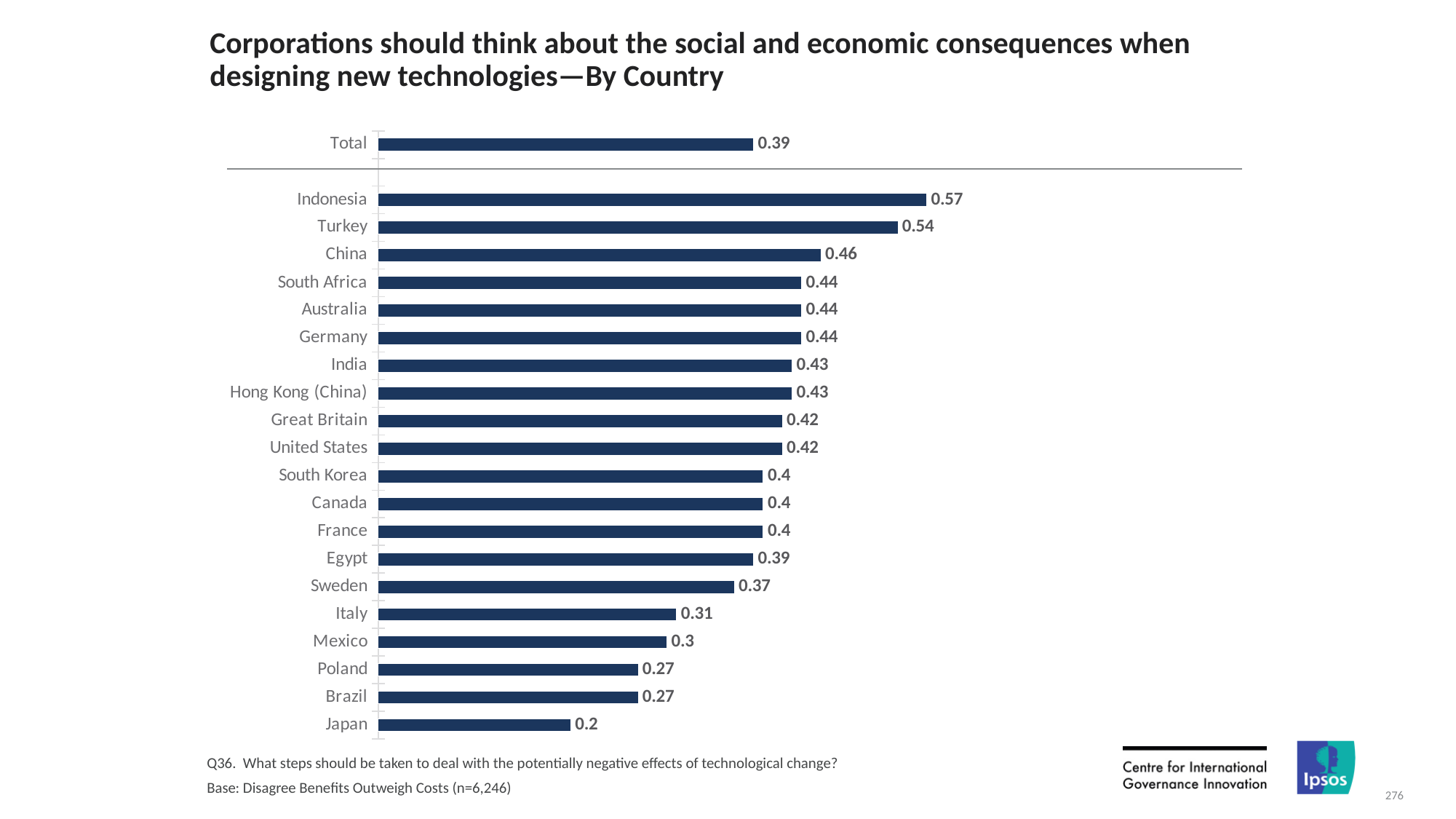
What is the value for Japan? 0.2 What is the difference between the values for China and Japan? 0.26 Which has a larger value, Italy or Mexico? Italy What kind of chart is shown on the slide? Bar chart What is the value for Total? 0.39 Which has a larger value, Egypt or Sweden? Egypt Which country has the lowest value? Japan What is the difference between the values for Indonesia and Turkey? 0.03 Which country has the highest value? Indonesia How many countries are listed below the Total bar? 20 What is the value for Sweden? 0.37 What is the value for Indonesia? 0.57